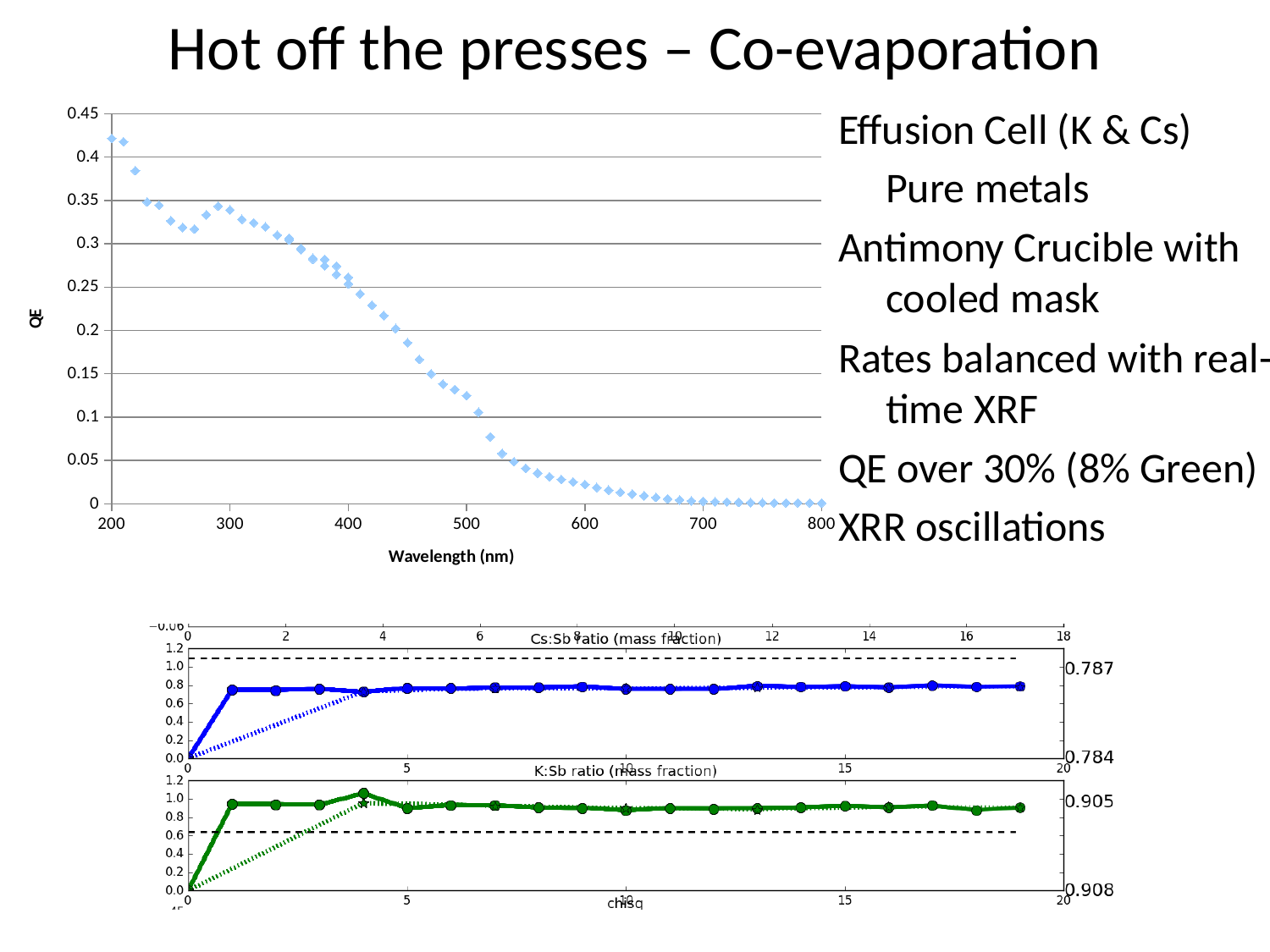
In the bottom chart titled 'Cs:Sb ratio (mass fraction)', is the plotted ratio at x = 10 greater or less than 1.0? less In the top chart of QE versus wavelength, what is the label of the y axis? QE In the top chart of QE versus wavelength, is the QE value at 400 nm greater or less than 0.2? greater In the top chart of QE versus wavelength, what kind of chart is it? scatter chart In the top chart of QE versus wavelength, what is the label of the x axis? Wavelength (nm) In the bottom chart titled 'Cs:Sb ratio (mass fraction)', what kind of chart is it? line chart In the top chart of QE versus wavelength, is the QE value at 500 nm greater or less than 0.2? less In the top chart of QE versus wavelength, do the QE values rise or fall as wavelength increases from 200 nm to 800 nm? fall